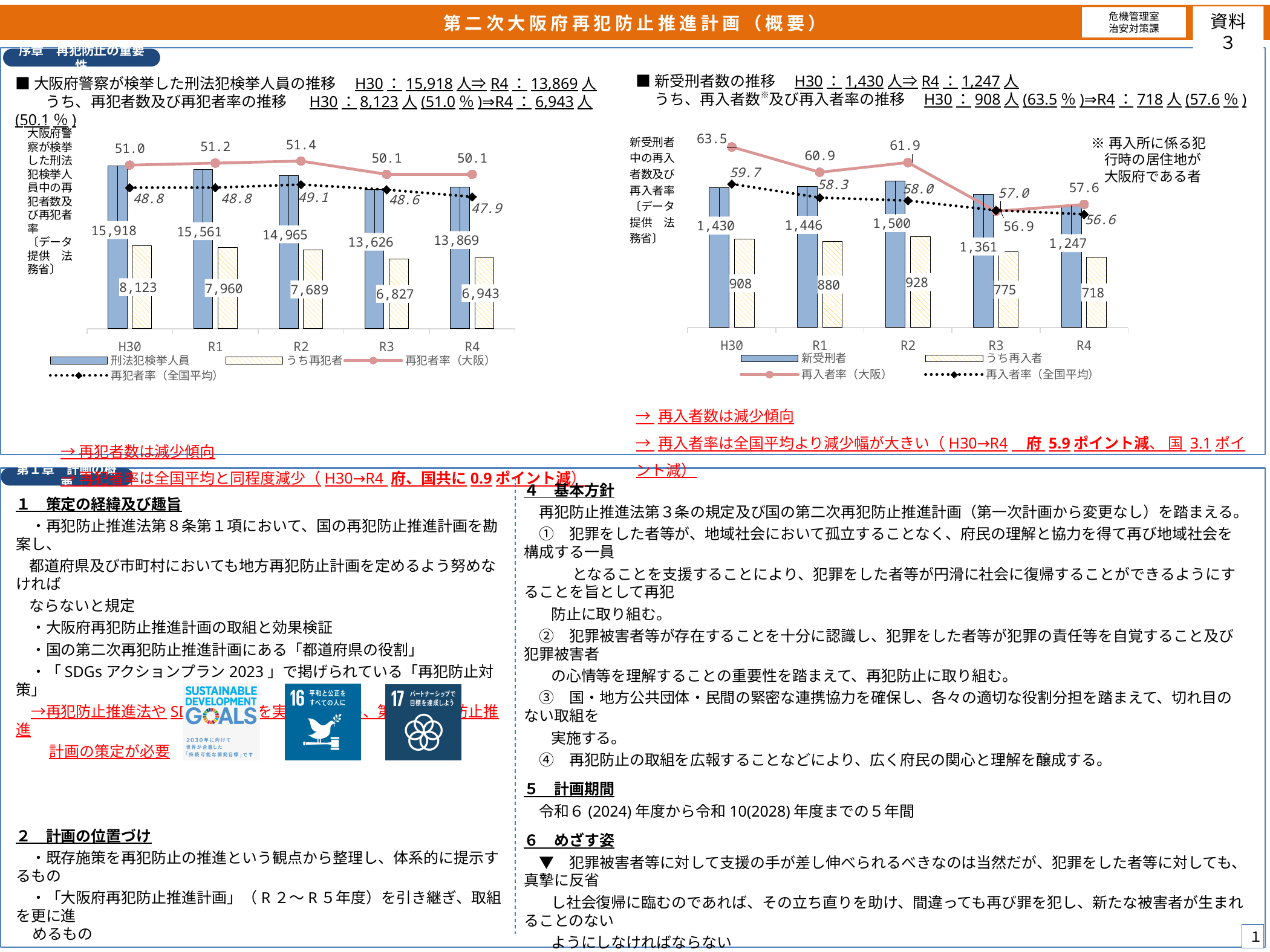
In the left chart, how many series does the legend list? 4 In the left chart, what is the difference between 刑法犯検挙人員 and うち再犯者 for R4? 6,926 In the right chart, what is the value of うち再入者 for R4? 718 In the left chart, which year has the lowest 刑法犯検挙人員? R3 In the right chart, how many years are shown on the x axis? 5 In the right chart, which year has the highest 再入者率（大阪）? H30 In the right chart (新受刑者数の推移), what is the value of 新受刑者 for R2? 1,500 What kind of chart is the right chart (新受刑者数の推移)? Combined bar and line chart In the left chart, what is the value of うち再犯者 for R3? 6,827 In the left chart, what is the 再犯者率（大阪） for R2? 51.4 In the right chart, is 再入者率（大阪） for R1 larger or smaller than 再入者率（全国平均） for R1? larger In the left chart (大阪府警察が検挙した刑法犯検挙人員の推移), what is the value of 刑法犯検挙人員 for H30? 15,918